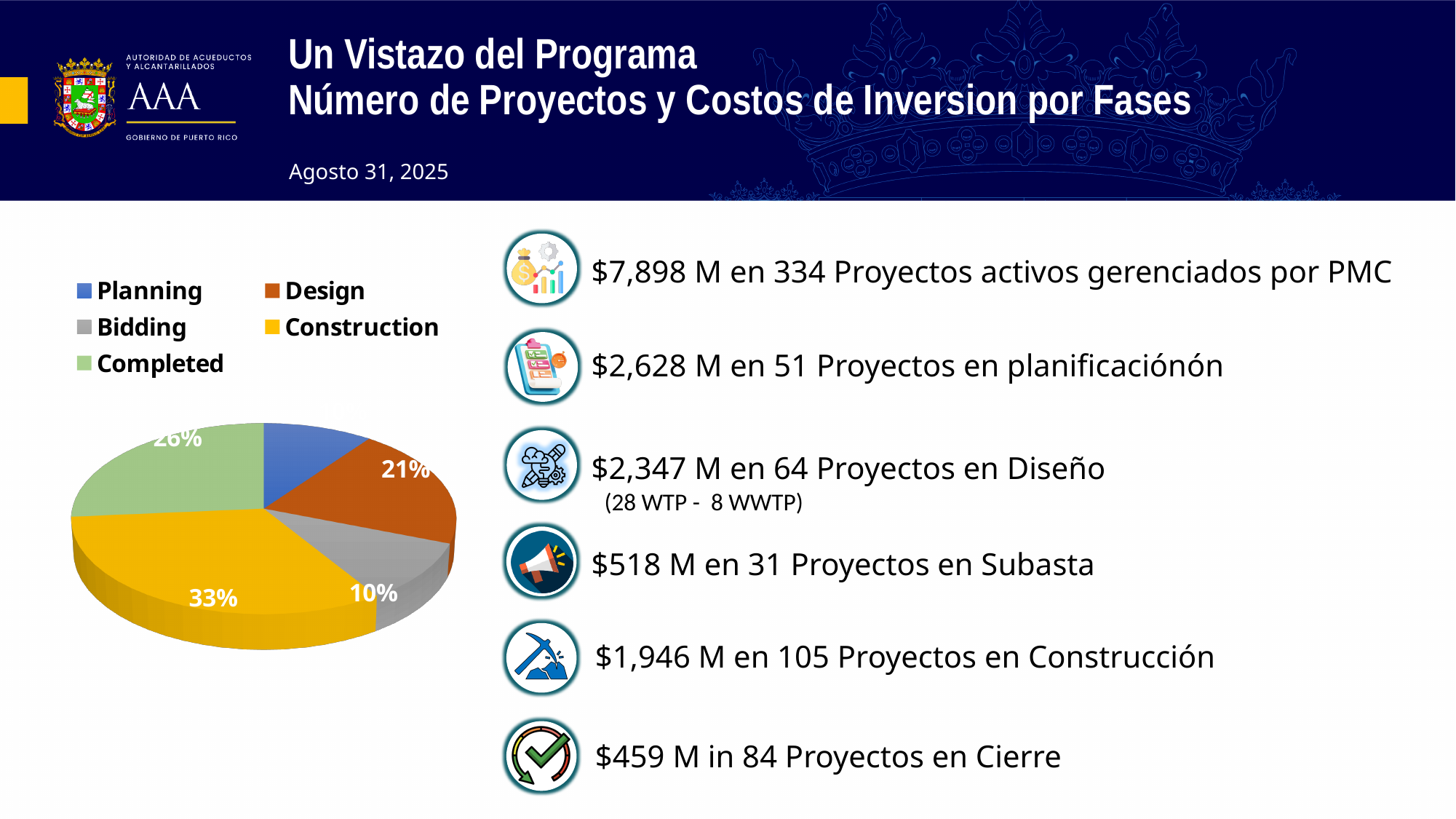
What percentage of the pie chart is Completed? 26% What colour represents Construction in the pie chart? yellow What percentage of the pie chart is Bidding? 10% Which category has the largest slice of the pie chart? Construction How many categories does the pie chart legend list? 5 What type of chart is shown on the slide? pie chart Which category is shown in blue in the pie chart legend? Planning What is the difference in percentage points between the Construction and Completed slices? 7% What is the difference in percentage points between the Design and Bidding slices? 11% What percentage of the pie chart is Construction? 33% What percentage of the pie chart is Design? 21% Which slice is larger in the pie chart, Construction or Completed? Construction